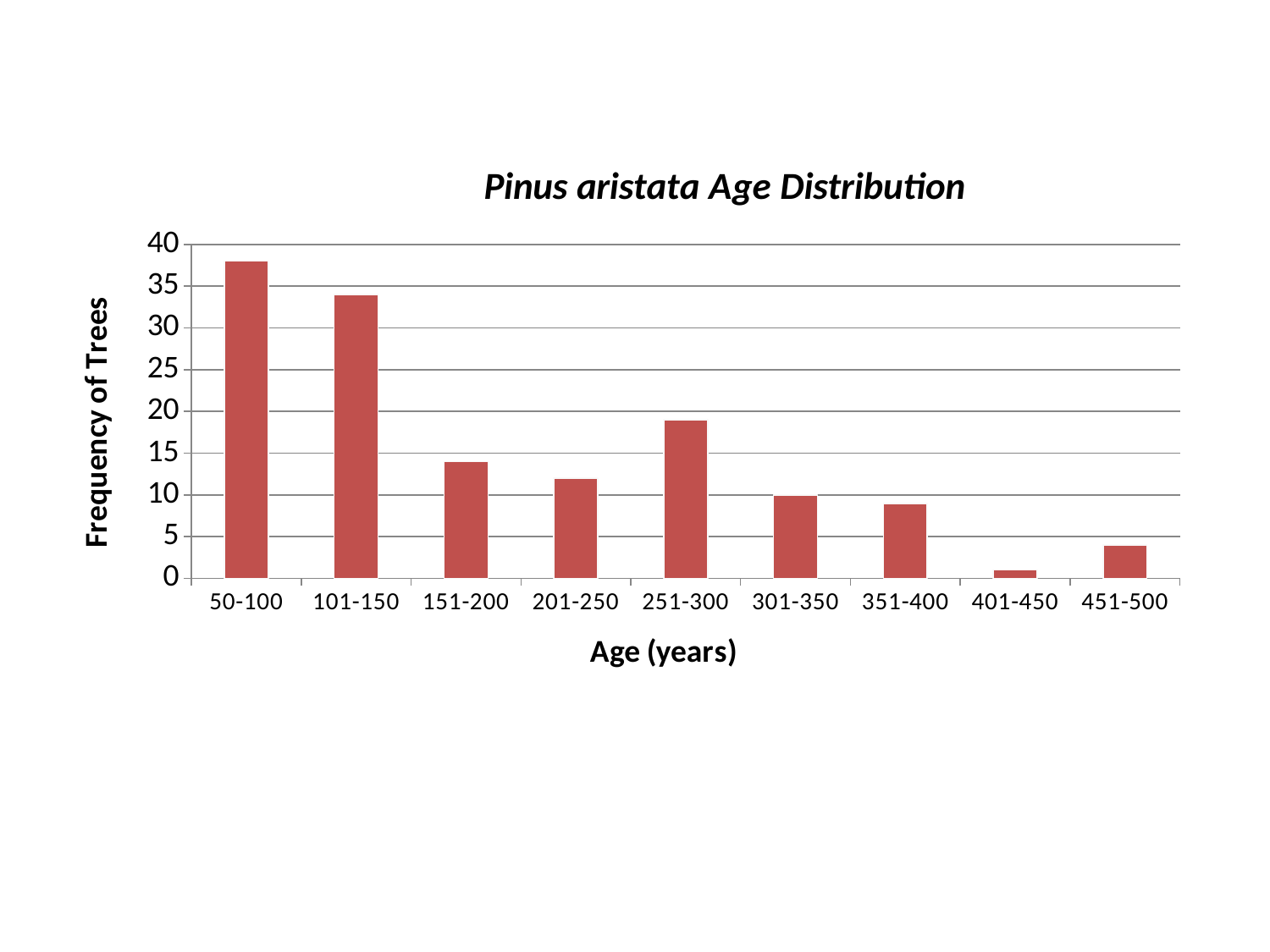
Which age category has the lowest frequency of trees? 401-450 Is the frequency of trees for the 50-100 age category greater or less than 35? greater Is the frequency of trees for the 101-150 age category greater or less than 30? greater What is the label of the y axis? Frequency of Trees What kind of chart is shown on the slide? bar chart Is the frequency of trees for the 251-300 age category greater or less than 15? greater Which age category has the highest frequency of trees? 50-100 How many age categories are shown on the x axis? 9 What is the title of the chart? Pinus aristata Age Distribution Which has a higher frequency of trees, the 251-300 category or the 201-250 category? 251-300